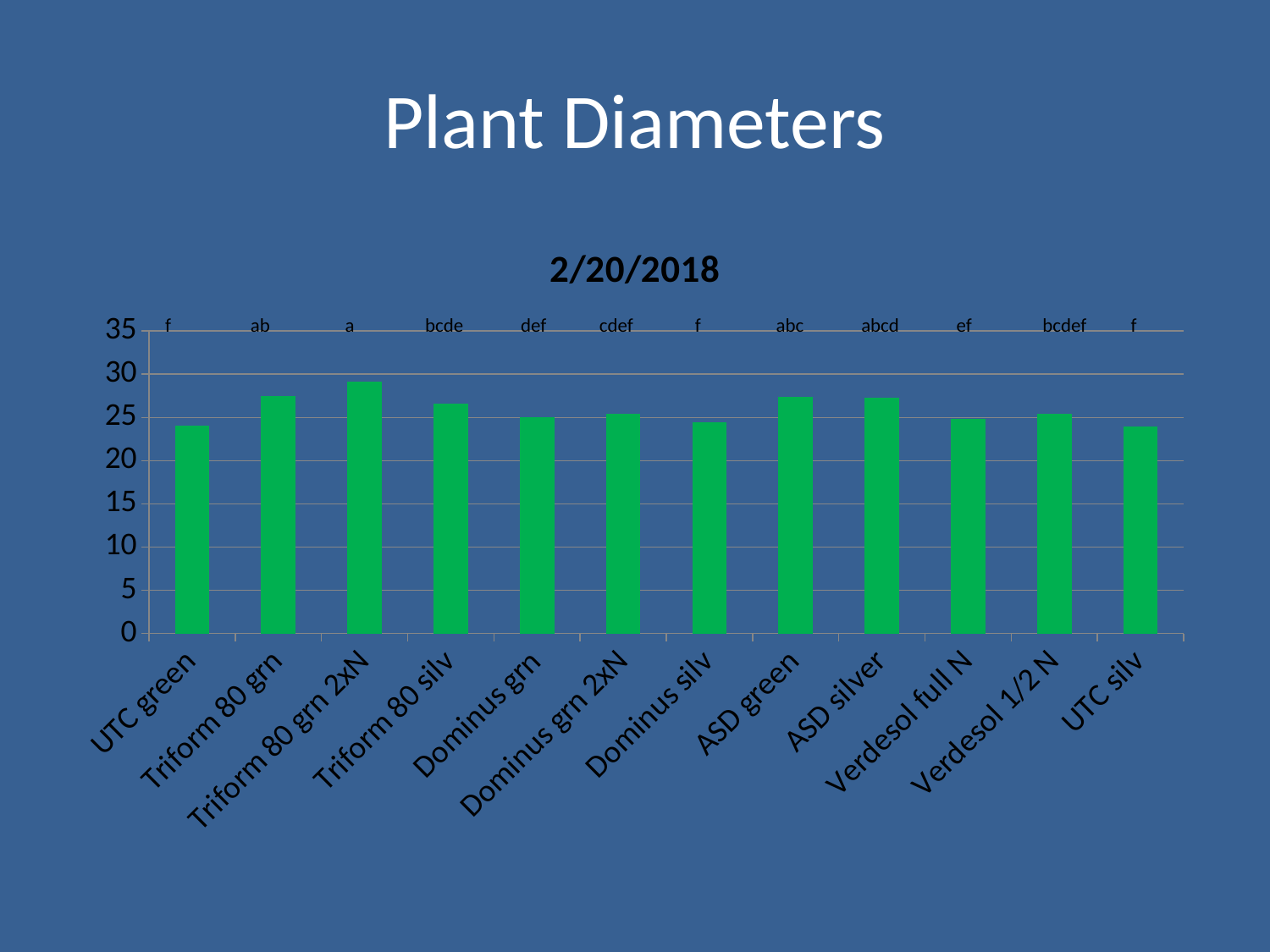
Is the value for ASD silver greater or less than 30? less Is the value for Triform 80 grn 2xN greater or less than 30? less Which is larger, the value for ASD green or the value for UTC silv? ASD green Is the value for UTC silv greater or less than 20? greater How many categories are plotted on the x axis of the chart? 12 What letter label appears above the bar for Triform 80 grn 2xN? a Which category has the highest bar in the chart? Triform 80 grn 2xN Which is larger, the value for Triform 80 grn 2xN or the value for UTC green? Triform 80 grn 2xN What kind of chart is shown on the slide? bar chart What is the title shown above the chart? 2/20/2018